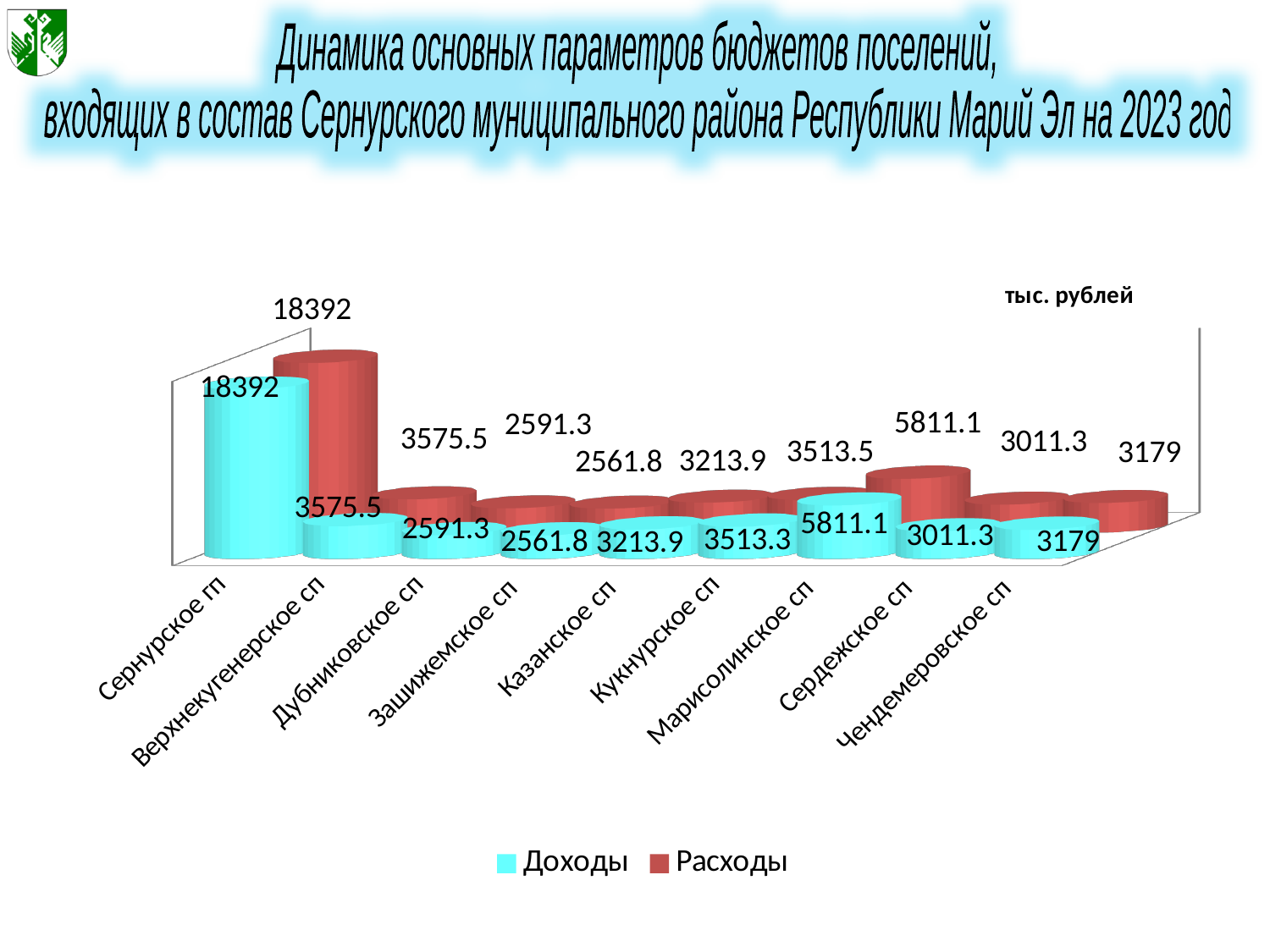
Which category has the highest Доходы value? Сернурское гп Which is larger, the Доходы value for Верхнекугенерское сп or for Казанское сп? Верхнекугенерское сп What is the Доходы value for Марисолинское сп? 5811.1 How many categories are shown on the x axis? 9 What kind of chart is shown on the slide? Bar chart What is the difference between the Расходы and Доходы values for Кукнурское сп? 0.2 How many series does the legend list? 2 What is the Расходы value for Зашижемское сп? 2561.8 What is the Расходы value for Кукнурское сп? 3513.5 What is the Доходы value for Чендемеровское сп? 3179 Which category has the lowest Расходы value? Зашижемское сп What is the difference between the Доходы values for Сернурское гп and Марисолинское сп? 12580.9